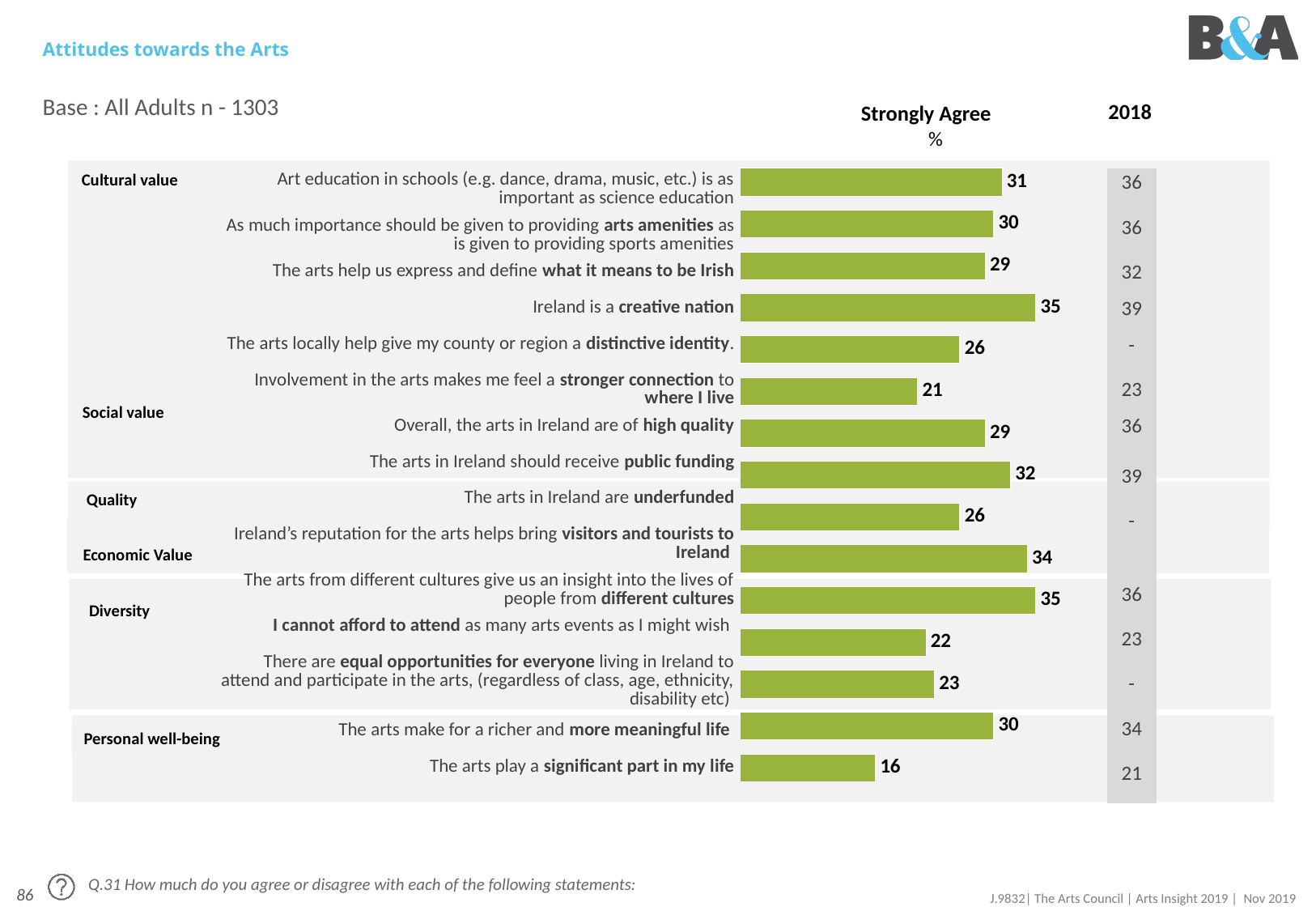
What is the difference between the Strongly Agree values for 'The arts in Ireland should receive public funding' and 'The arts in Ireland are underfunded'? 6 Which has a higher Strongly Agree value: 'Ireland's reputation for the arts helps bring visitors and tourists to Ireland' or 'Overall, the arts in Ireland are of high quality'? Ireland's reputation for the arts helps bring visitors and tourists to Ireland What is the Strongly Agree value for 'The arts in Ireland should receive public funding'? 32 What is the base sample size stated on the slide? All Adults n - 1303 Which statement has the lowest Strongly Agree percentage? The arts play a significant part in my life What percentage strongly agree that Ireland is a creative nation? 35 What percentage strongly agree that the arts play a significant part in my life? 16 What is the difference between the Strongly Agree values for 'Ireland is a creative nation' and 'Involvement in the arts makes me feel a stronger connection to where I live'? 14 How many statements are plotted as bars in the chart? 15 What is the Strongly Agree value for 'The arts make for a richer and more meaningful life'? 30 What kind of chart is shown on the slide? Bar chart What is the Strongly Agree value for 'I cannot afford to attend as many arts events as I might wish'? 22